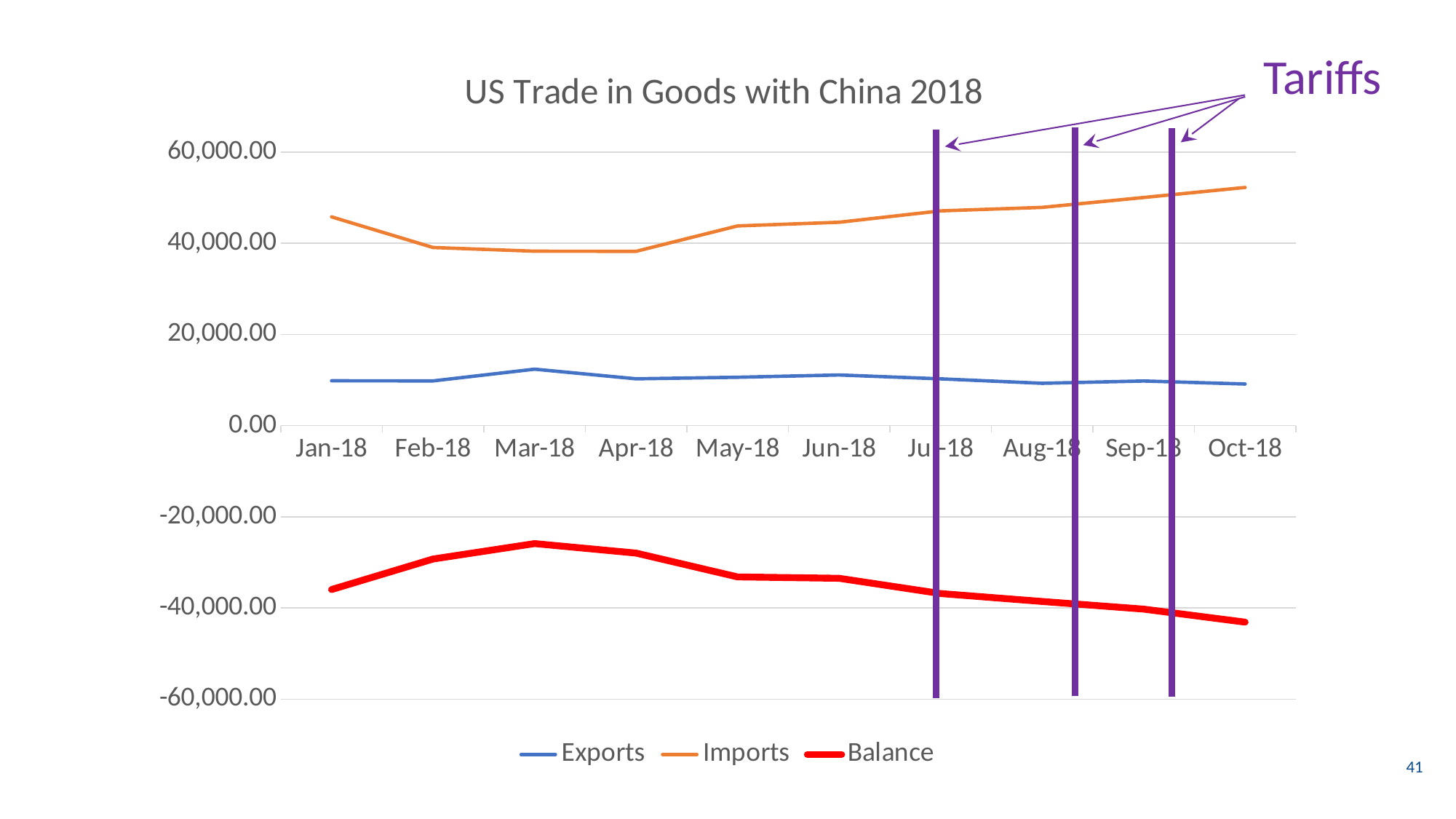
Is the value for Balance in Oct-18 greater or less than -40,000.00? less Is the value for Imports in Oct-18 greater or less than 40,000.00? greater Is the value for Exports in Jan-18 greater or less than 20,000.00? less In which month are Imports highest? Oct-18 In which month are Exports highest? Mar-18 Do Imports rise or fall from Apr-18 to Oct-18? Rise Which is larger in Jan-18, Imports or Exports? Imports What kind of chart is shown on the slide? Line chart What is the title of the chart? US Trade in Goods with China 2018 How many series does the legend list? 3 How many months are plotted along the x axis? 10 In which month is the Balance lowest (most negative)? Oct-18